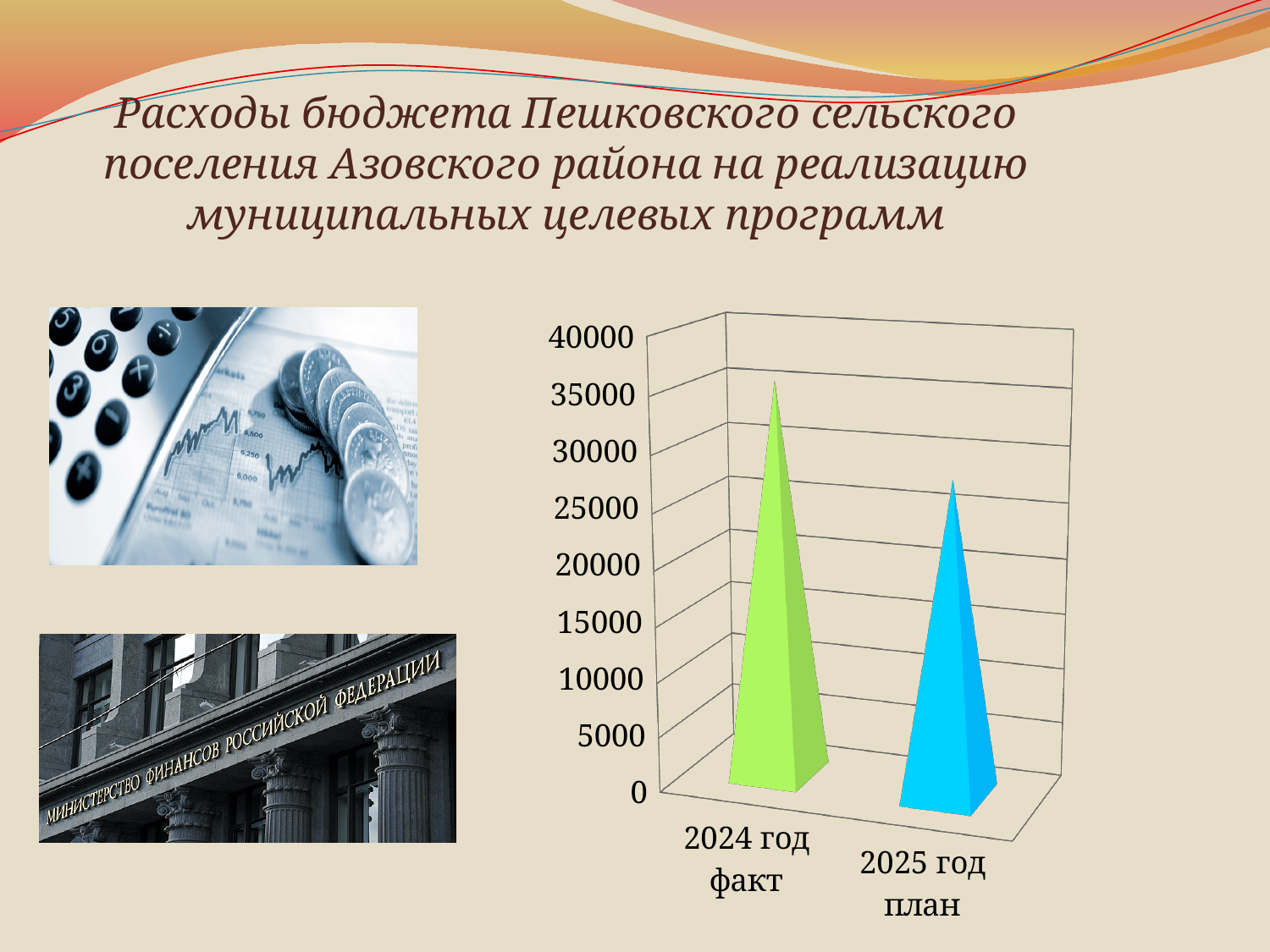
How many categories are shown on the x axis of the chart? 2 What is the highest value shown on the vertical axis of the chart? 40000 Which category has the lowest value in the chart? 2025 год план What colour is the bar for 2025 год план? blue Is the value for 2025 год план greater or less than 20000? greater Is the value for 2024 год факт greater or less than 30000? greater Which category has the highest value in the chart? 2024 год факт What kind of chart is shown on the slide? bar chart Is the value for 2024 год факт greater or less than 40000? less Do the values rise or fall from 2024 год факт to 2025 год план? fall Which is larger, the value for 2024 год факт or the value for 2025 год план? 2024 год факт